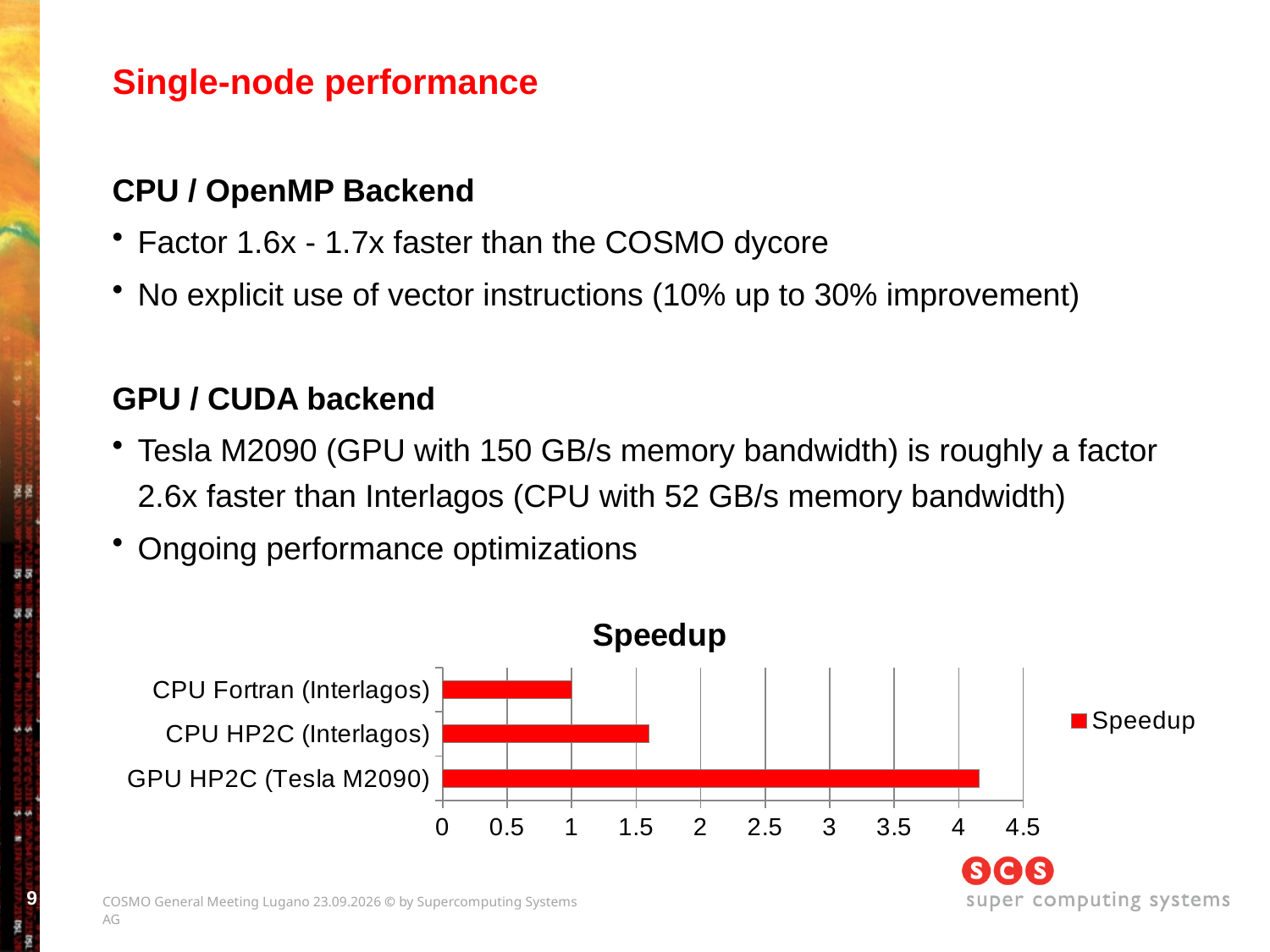
How many categories are plotted in the Speedup chart? 3 What kind of chart is shown on the slide? bar chart Which category has the highest speedup in the chart? GPU HP2C (Tesla M2090) Is the speedup for GPU HP2C (Tesla M2090) greater or less than 4? greater What is the title of the chart on the slide? Speedup What is the name of the series shown in the chart legend? Speedup Is the speedup for CPU HP2C (Interlagos) greater or less than 1? greater How many series does the legend of the Speedup chart list? 1 Is the speedup for CPU HP2C (Interlagos) greater or less than 2? less Which has the larger speedup, CPU HP2C (Interlagos) or CPU Fortran (Interlagos)? CPU HP2C (Interlagos) Which category has the lowest speedup in the chart? CPU Fortran (Interlagos)